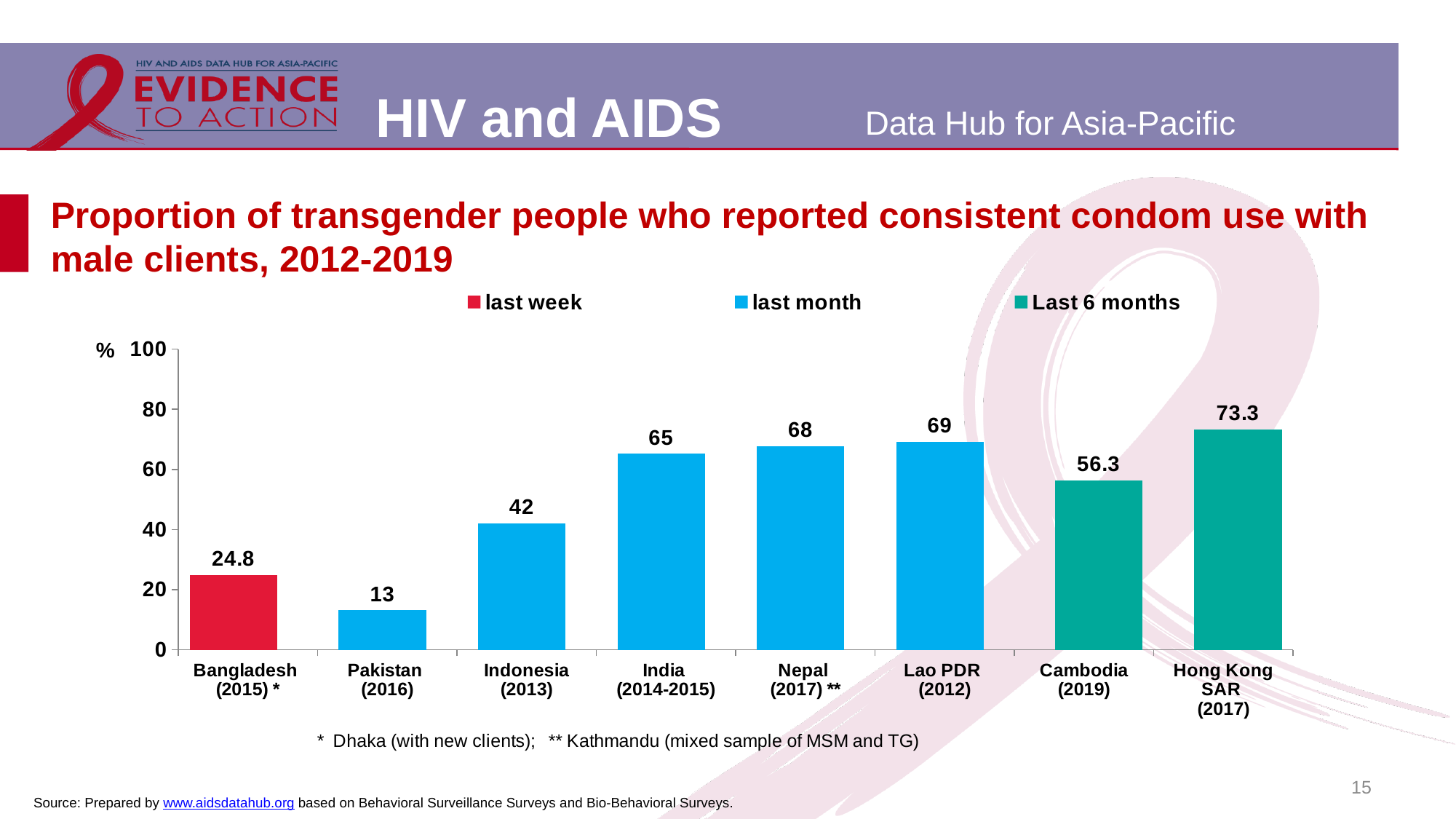
What kind of chart is shown? bar chart Which country has the highest value? Hong Kong SAR (2017) Which is larger, the value for India (2014-2015) or the value for Cambodia (2019)? India (2014-2015) What is the value for Cambodia (2019)? 56.3 What is the difference between the values for Hong Kong SAR (2017) and Cambodia (2019)? 17 How many countries are shown on the chart? 8 What is the value for Hong Kong SAR (2017)? 73.3 How many series does the legend list? 3 What is the difference between the values for Lao PDR (2012) and Indonesia (2013)? 27 Which country has the lowest value? Pakistan (2016) Which legend series does the Bangladesh (2015) bar belong to? last week What is the value for Bangladesh (2015)? 24.8